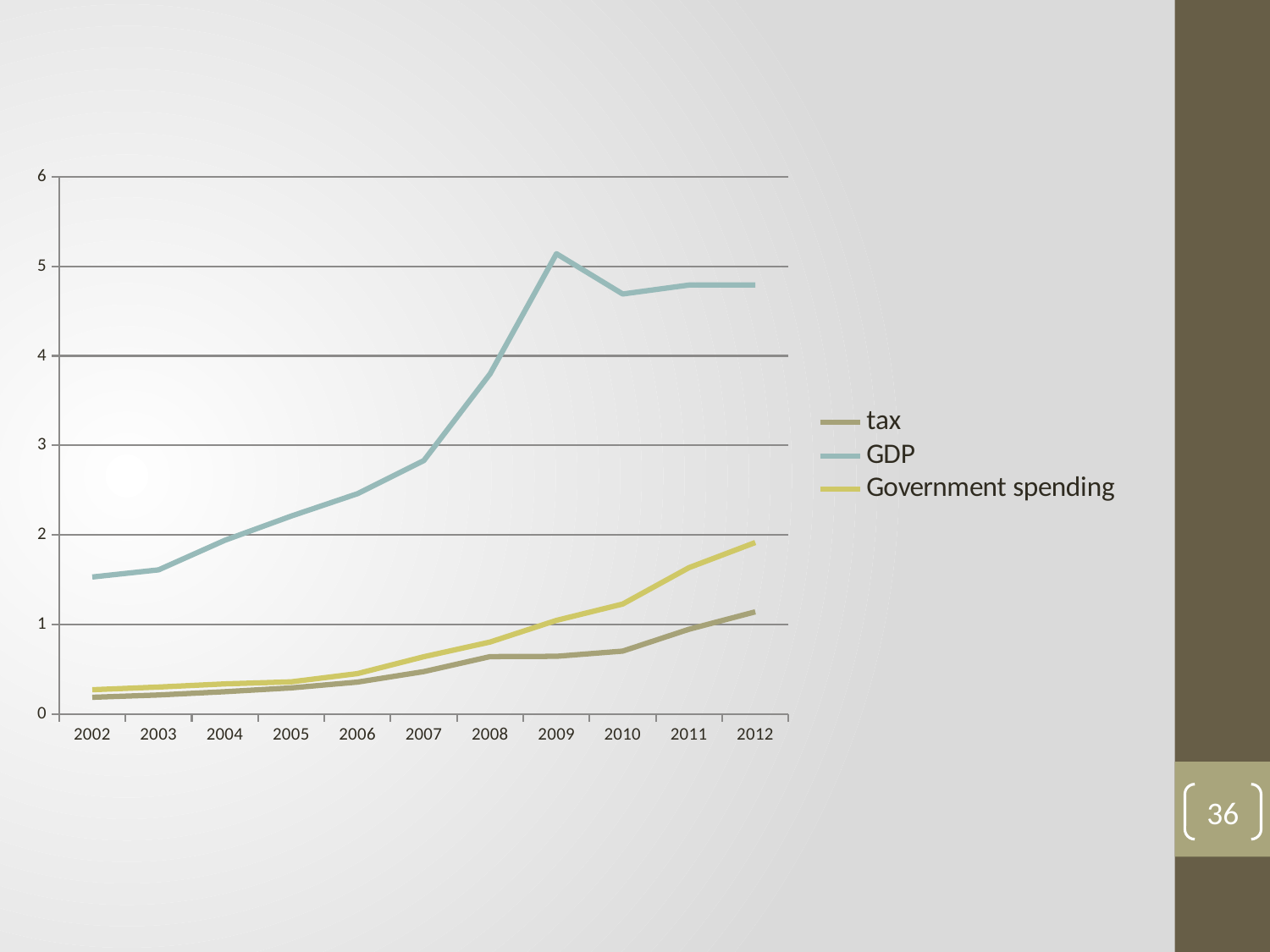
In 2012, which is larger: Government spending or tax? Government spending Does the Government spending line rise or fall from 2002 to 2012? rise Is the tax value for 2002 greater or less than 1? less How many series does the legend list? 3 What are the three entries listed in the legend? tax, GDP, Government spending Is the Government spending value for 2012 greater or less than 1? greater Is the GDP value larger in 2009 or in 2010? 2009 Is the GDP value for 2007 greater or less than 2? greater How many years are plotted along the x axis? 11 What kind of chart is shown on the slide? line chart In which year does the GDP line reach its highest value? 2009